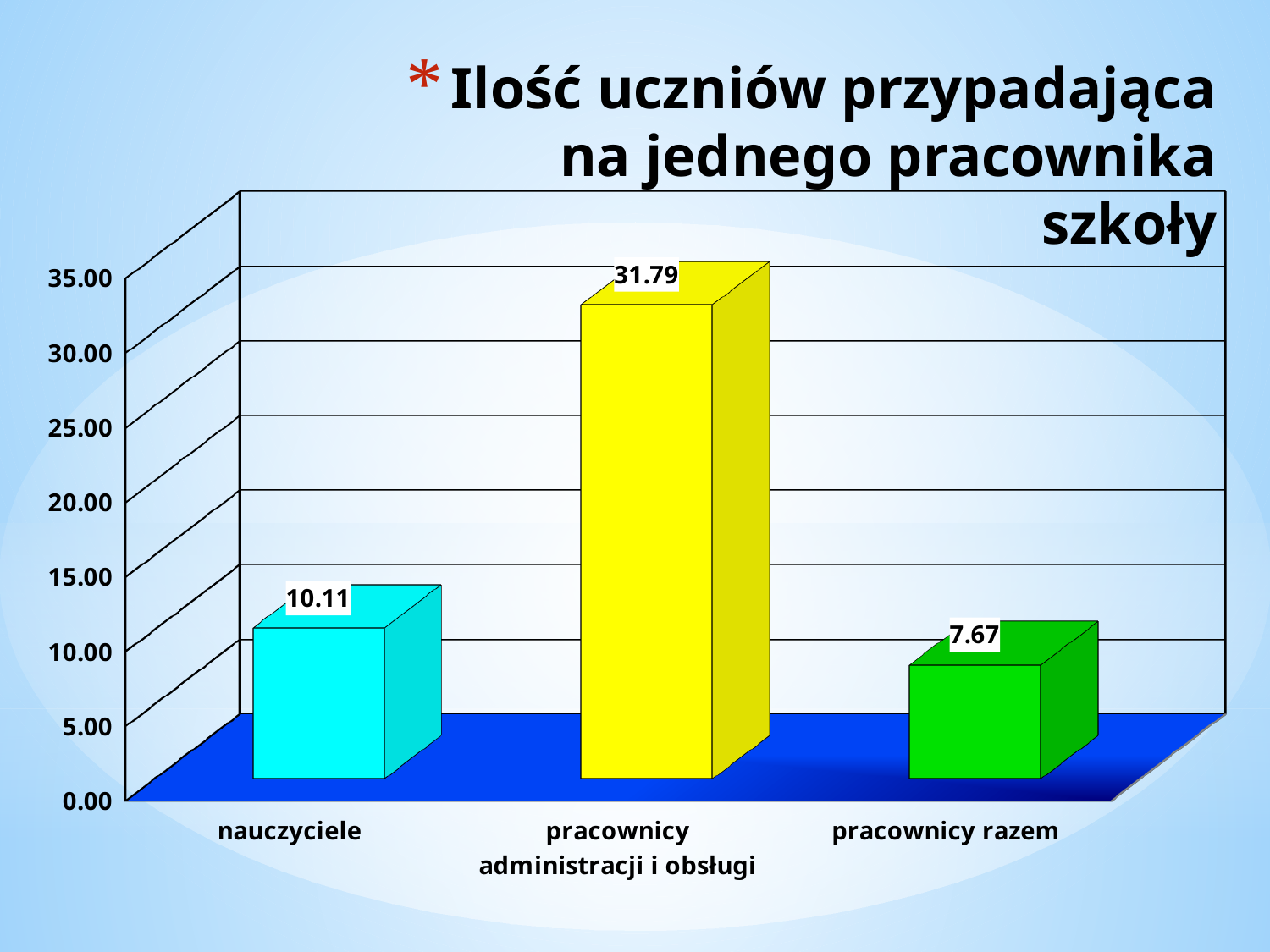
Is the value for pracownicy administracji i obsługi greater or less than 30.00? greater Which category has the lowest value? pracownicy razem How many categories are shown on the chart? 3 What colour is the bar for pracownicy administracji i obsługi? yellow What is the value for pracownicy administracji i obsługi? 31.79 Which is larger, the value for nauczyciele or the value for pracownicy razem? nauczyciele What is the value for nauczyciele? 10.11 Which category has the highest value? pracownicy administracji i obsługi What is the value for pracownicy razem? 7.67 What is the difference between the values for nauczyciele and pracownicy razem? 2.44 What is the difference between the values for pracownicy administracji i obsługi and nauczyciele? 21.68 What kind of chart is shown on the slide? bar chart